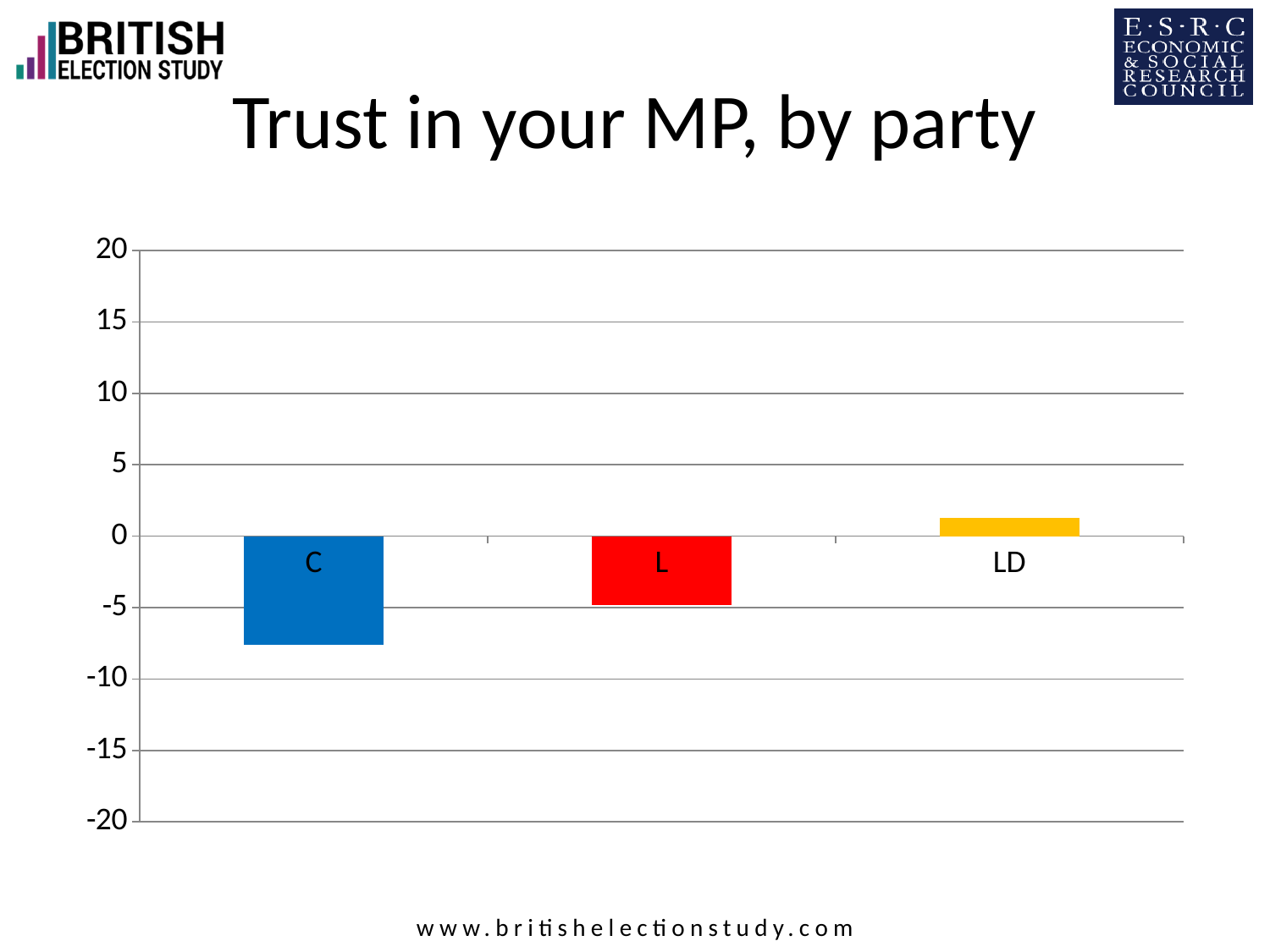
Is the value for C greater or less than -5? less Do the values rise or fall moving from C to LD along the x axis? rise Which party has the lowest value for trust in your MP? C How many parties (categories) are shown in the chart? 3 Which party has the highest value for trust in your MP? LD What kind of chart is shown on the slide? bar chart Is the value for L greater or less than -10? greater Is the value for LD greater or less than 5? less What is the title of the chart? Trust in your MP, by party Which is larger, the value for C or the value for L? L What colour is the bar for LD? yellow